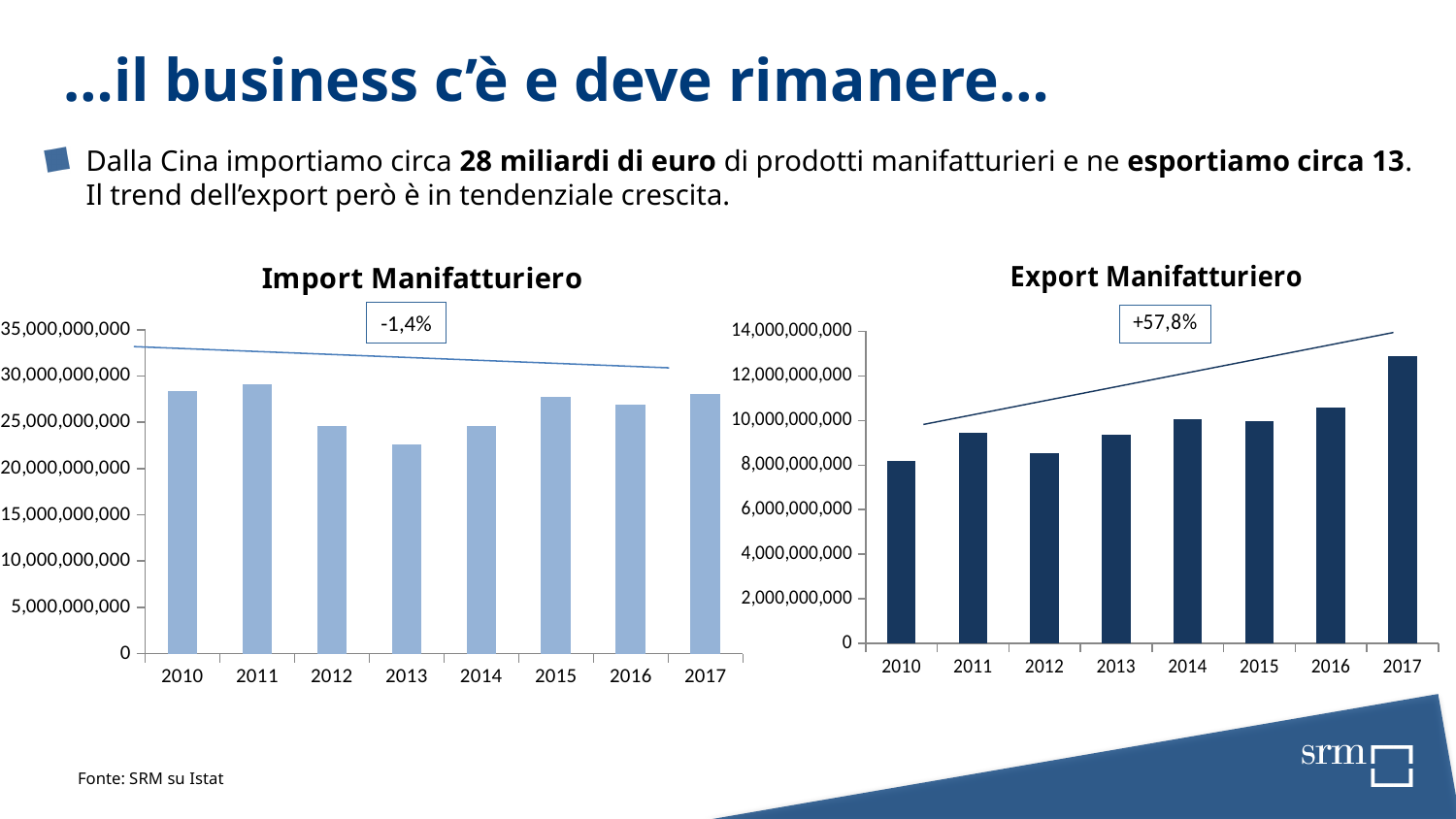
In the Import Manifatturiero chart, is the value for 2013 greater or less than 25,000,000,000? less In the Export Manifatturiero chart, is the value for 2010 greater or less than 10,000,000,000? less In the Import Manifatturiero chart, which is larger, the value for 2013 or the value for 2015? 2015 How many years are shown on the x axis of the Export Manifatturiero chart? 8 In the Export Manifatturiero chart, is the value for 2017 greater or less than 12,000,000,000? greater According to the trend line on the Export Manifatturiero chart, do export values generally rise or fall from 2010 to 2017? rise In the Import Manifatturiero chart, which year has the lowest value? 2013 What kind of chart is the Import Manifatturiero chart? bar chart What percentage change is annotated on the Import Manifatturiero chart? -1,4% In the Export Manifatturiero chart, which year has the highest value? 2017 In the Export Manifatturiero chart, which is larger, the value for 2010 or the value for 2017? 2017